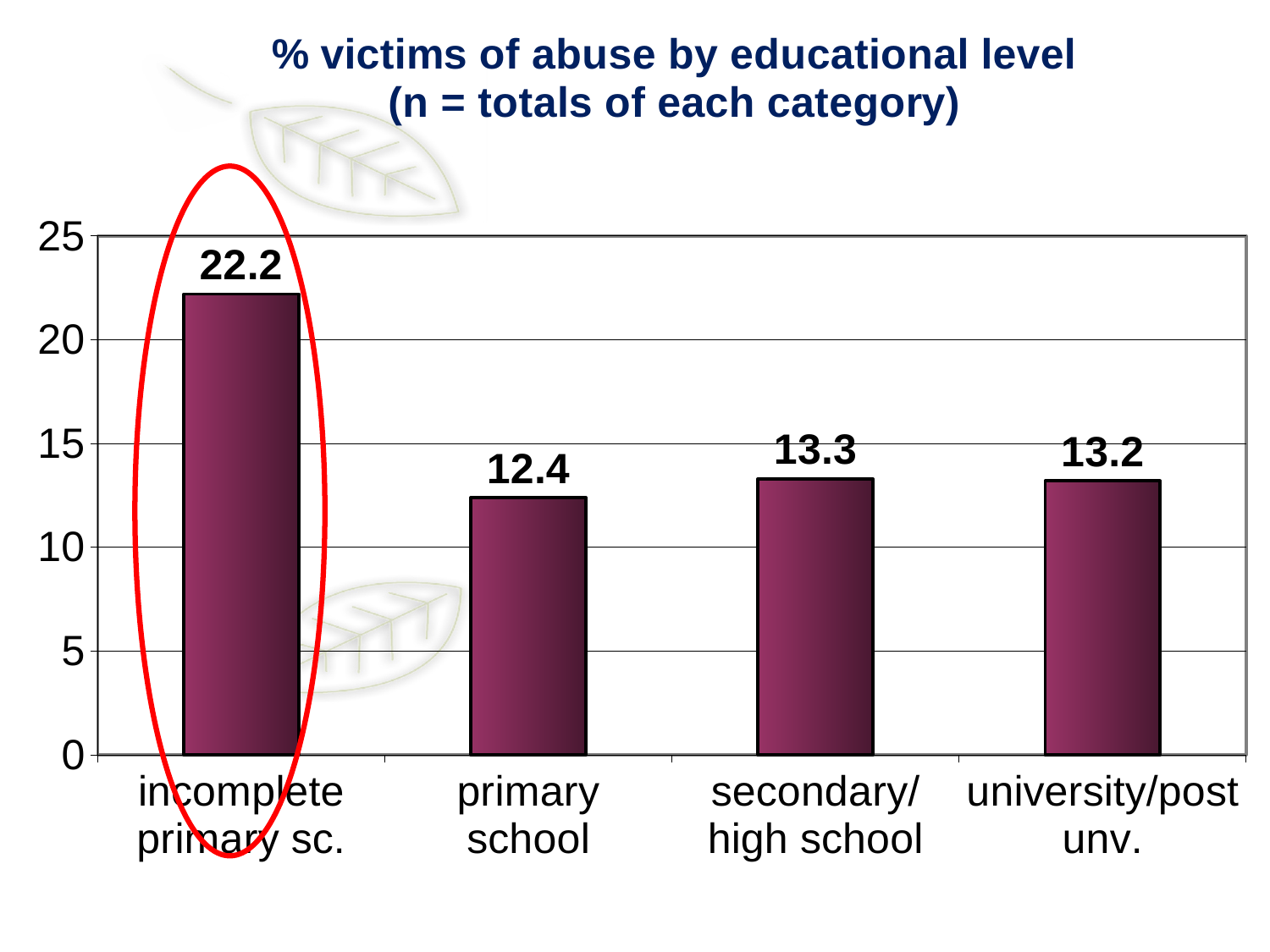
What kind of chart is shown on the slide? bar chart What is the value for primary school? 12.4 Which is larger, the value for incomplete primary sc. or the value for secondary/high school? incomplete primary sc. What is the value for university/post unv.? 13.2 Is the value for primary school greater or less than 15? less Which educational level has the highest value? incomplete primary sc. What is the title of the chart? % victims of abuse by educational level (n = totals of each category) What is the value for secondary/high school? 13.3 What is the value for incomplete primary sc.? 22.2 Which educational level has the lowest value? primary school What is the difference between the values for incomplete primary sc. and primary school? 9.8 How many educational level categories are shown in the chart? 4